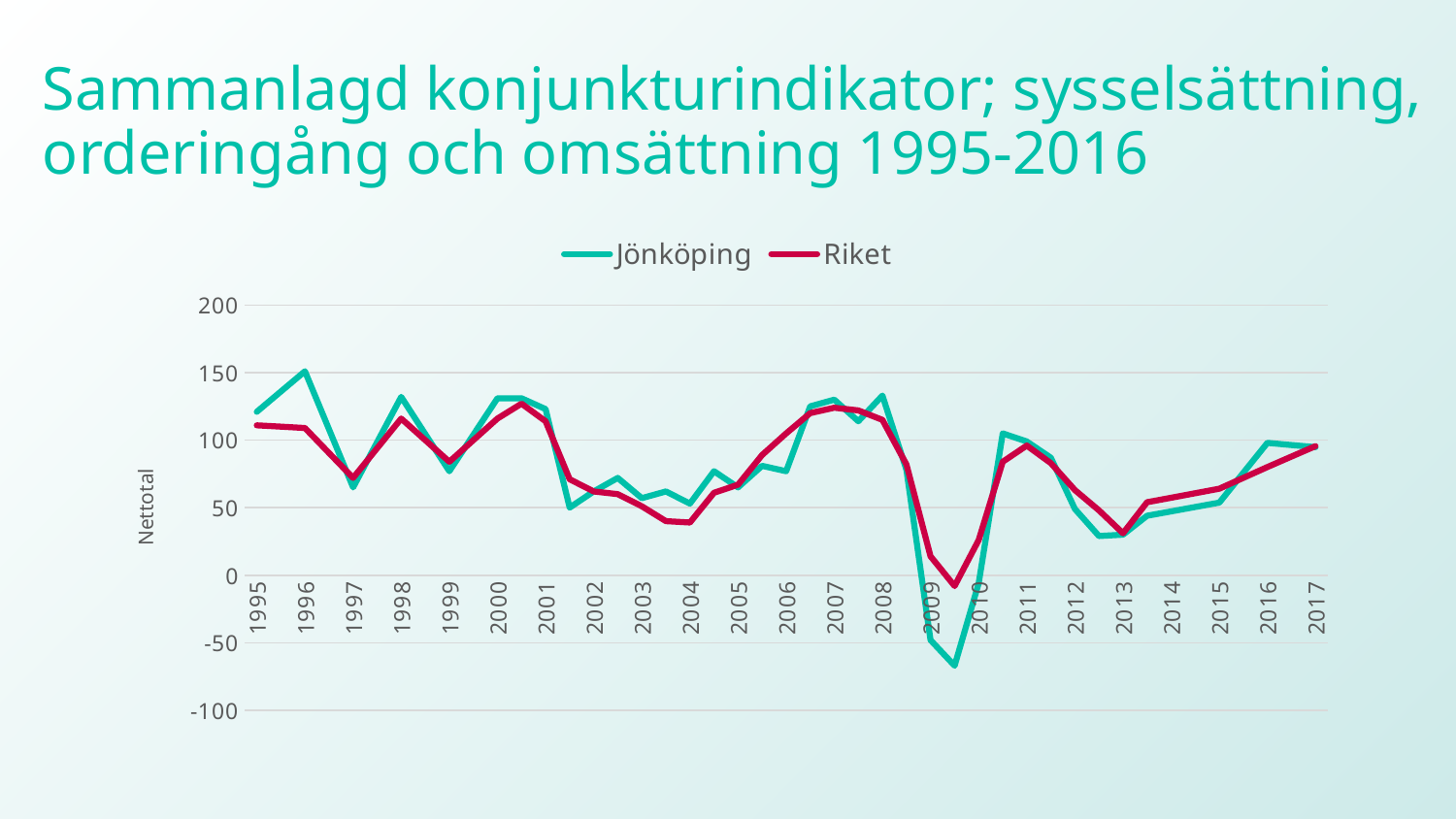
Is the value for Riket in 2004 greater or less than 50? less What are the two series named in the legend? Jönköping and Riket What kind of chart is shown on the slide? line chart How many series does the legend list? 2 In which year does the Jönköping series reach its highest value? 1996 Is the value for Jönköping in 1996 greater or less than 100? greater How many years are labelled along the x axis? 23 Does the Jönköping series rise or fall from 2013 to 2016? rise Which series has the higher value in 2009, Jönköping or Riket? Riket What is the label on the vertical axis? Nettotal